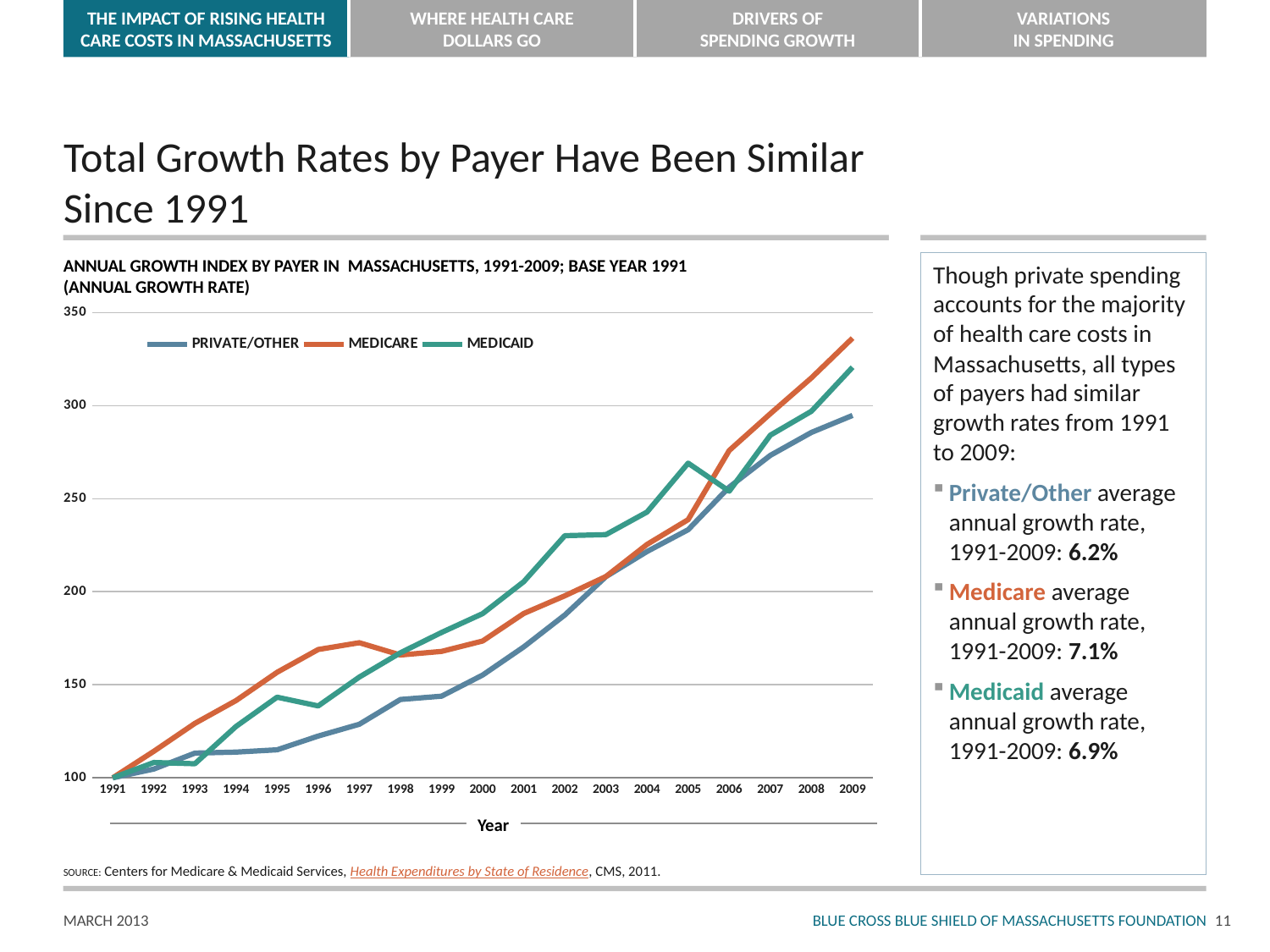
Is the value for Private/Other in 2002 greater or less than 200? less Is the value for Medicare in 2005 greater or less than 250? less How many series does the chart's legend list? 3 Do the index values for the three payers rise or fall from 1991 to 2009? rise Which payer has the lowest index value in 2009? Private/Other Is the value for Medicare in 2009 greater or less than 300? greater What is the index value for all three payers in the base year 1991? 100 Which payer has the highest index value in 2009? Medicare How many years are plotted along the x axis of the chart? 19 In 2005, which is larger: the Medicaid index or the Private/Other index? Medicaid What kind of chart is shown on the slide? line chart